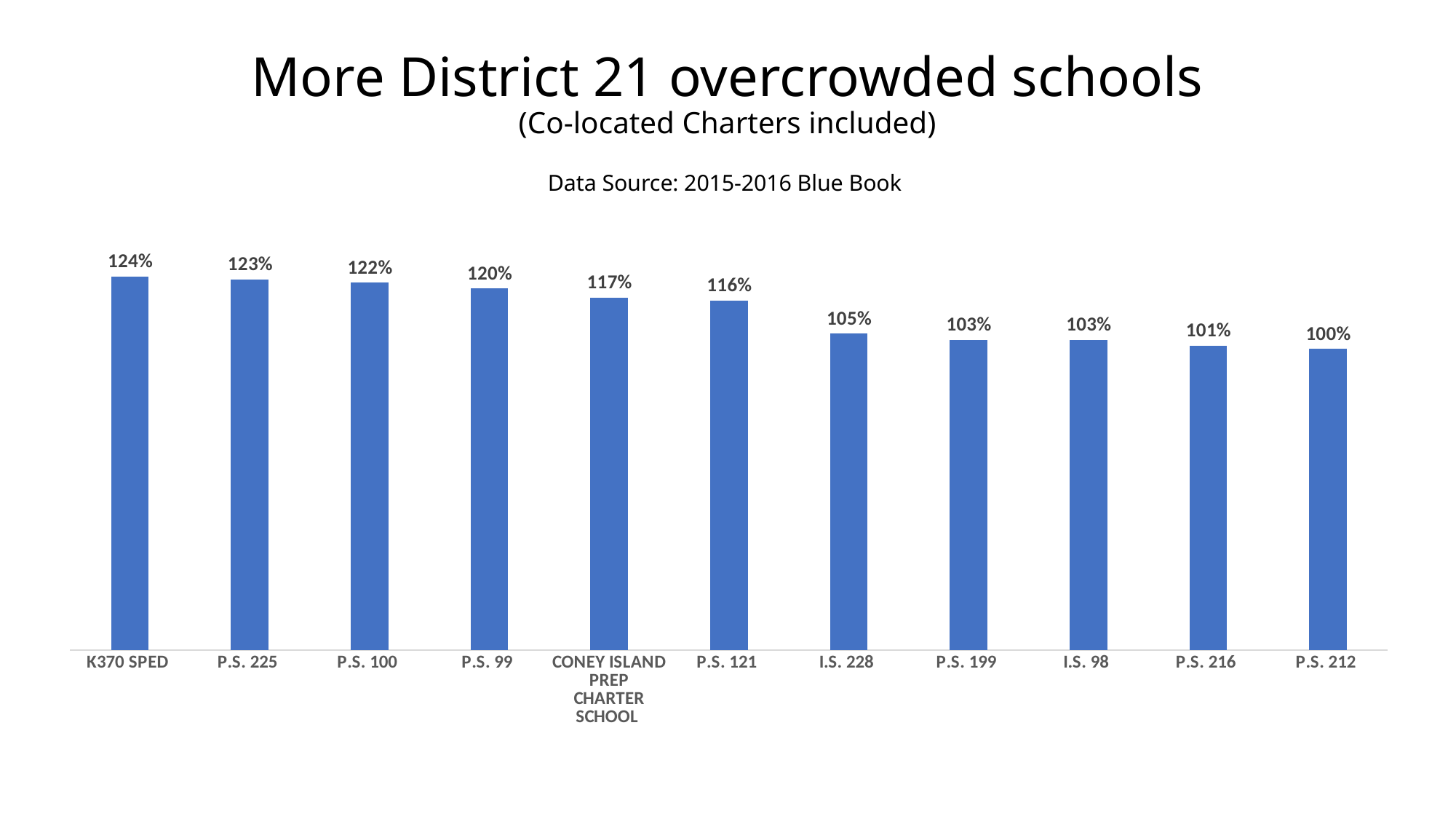
What is the value for P.S. 212? 100% Which school has the highest value? K370 SPED How many schools are shown in the chart? 11 What is the value for I.S. 228? 105% Which school has the lowest value? P.S. 212 What is the difference between the values for P.S. 121 and I.S. 228? 11% What is the value for K370 SPED? 124% What kind of chart is shown on the slide? Bar chart What is the value for Coney Island Prep Charter School? 117% What is the difference between the values for K370 SPED and P.S. 212? 24% Do the values rise or fall from left to right along the x axis? Fall Which is larger, the value for P.S. 99 or the value for P.S. 216? P.S. 99